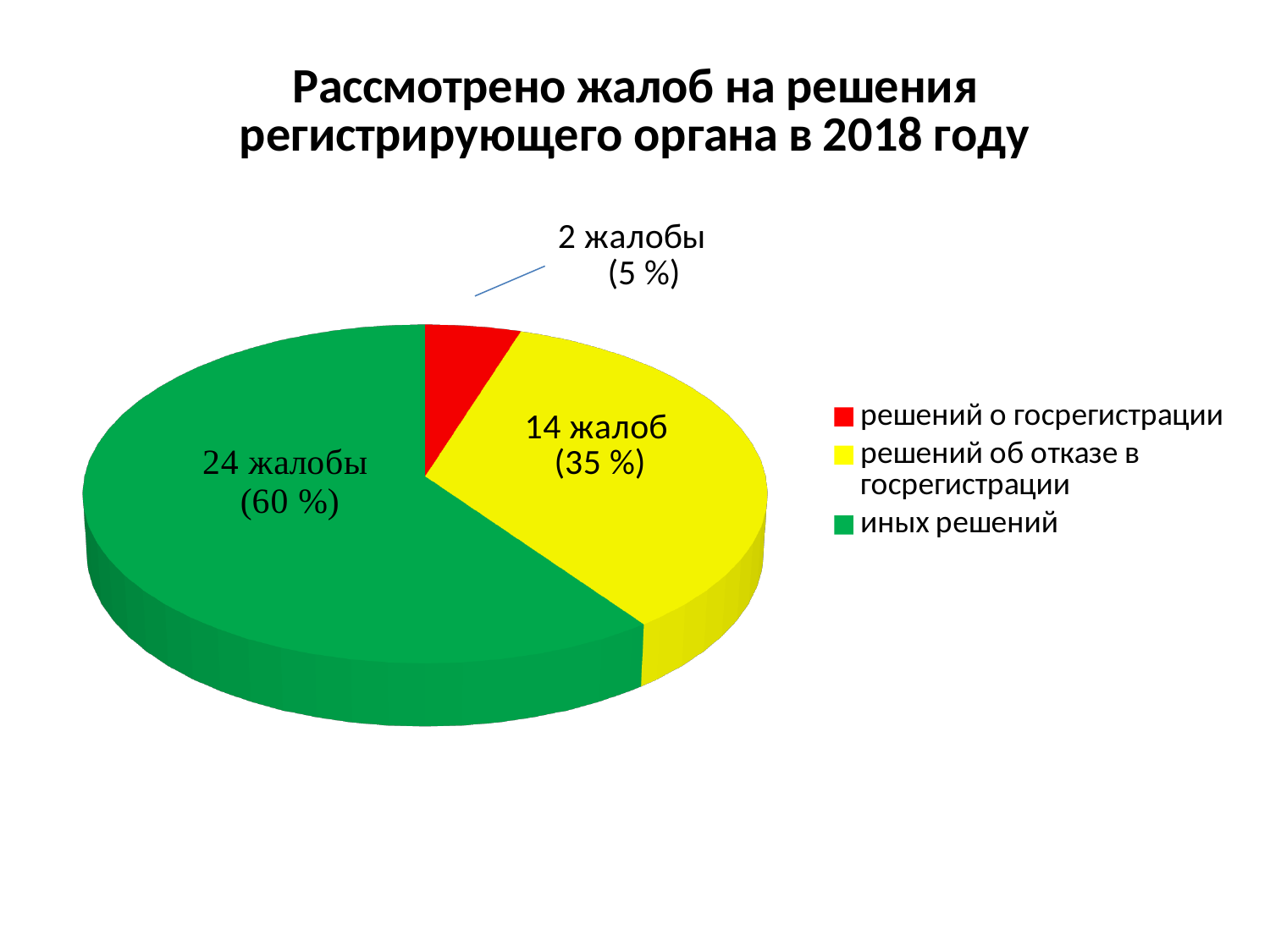
What is the difference in complaints between иных решений and решений об отказе в госрегистрации? 10 How many complaints concerned иных решений? 24 жалобы How many complaints concerned решений об отказе в госрегистрации? 14 жалоб Which category has the largest slice? иных решений What colour is the slice for иных решений? green What share of the pie does решений об отказе в госрегистрации take? 35 % Which category has the smallest slice? решений о госрегистрации How many categories does the pie chart have? 3 What share of the pie does иных решений take? 60 % How many complaints concerned решений о госрегистрации? 2 жалобы Which has more complaints: решений об отказе в госрегистрации or решений о госрегистрации? решений об отказе в госрегистрации What kind of chart is shown on the slide? pie chart